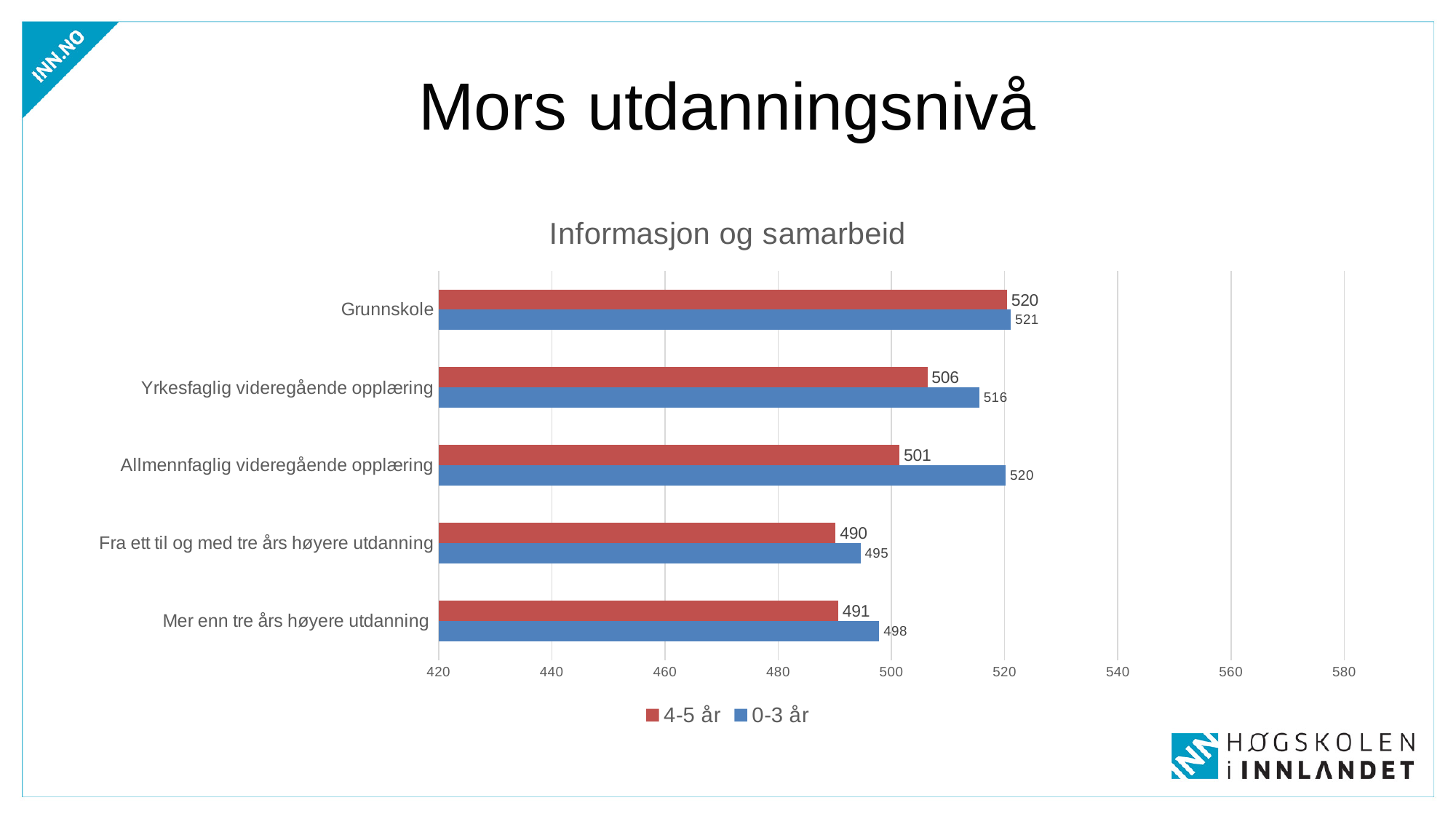
How many categories are shown on the chart? 5 Which is larger for Fra ett til og med tre års høyere utdanning: the 4-5 år value or the 0-3 år value? 0-3 år How many series does the legend list? 2 Which category has the lowest value in the 4-5 år series? Fra ett til og med tre års høyere utdanning What is the difference between the 0-3 år and 4-5 år values for Yrkesfaglig videregående opplæring? 10 What is the value for Allmennfaglig videregående opplæring in the 4-5 år series? 501 What is the difference between the 0-3 år and 4-5 år values for Allmennfaglig videregående opplæring? 19 Which category has the highest value in the 0-3 år series? Grunnskole What is the value for Grunnskole in the 0-3 år series? 521 What is the title of the chart? Informasjon og samarbeid What is the value for Mer enn tre års høyere utdanning in the 0-3 år series? 498 What kind of chart is shown on the slide? Bar chart